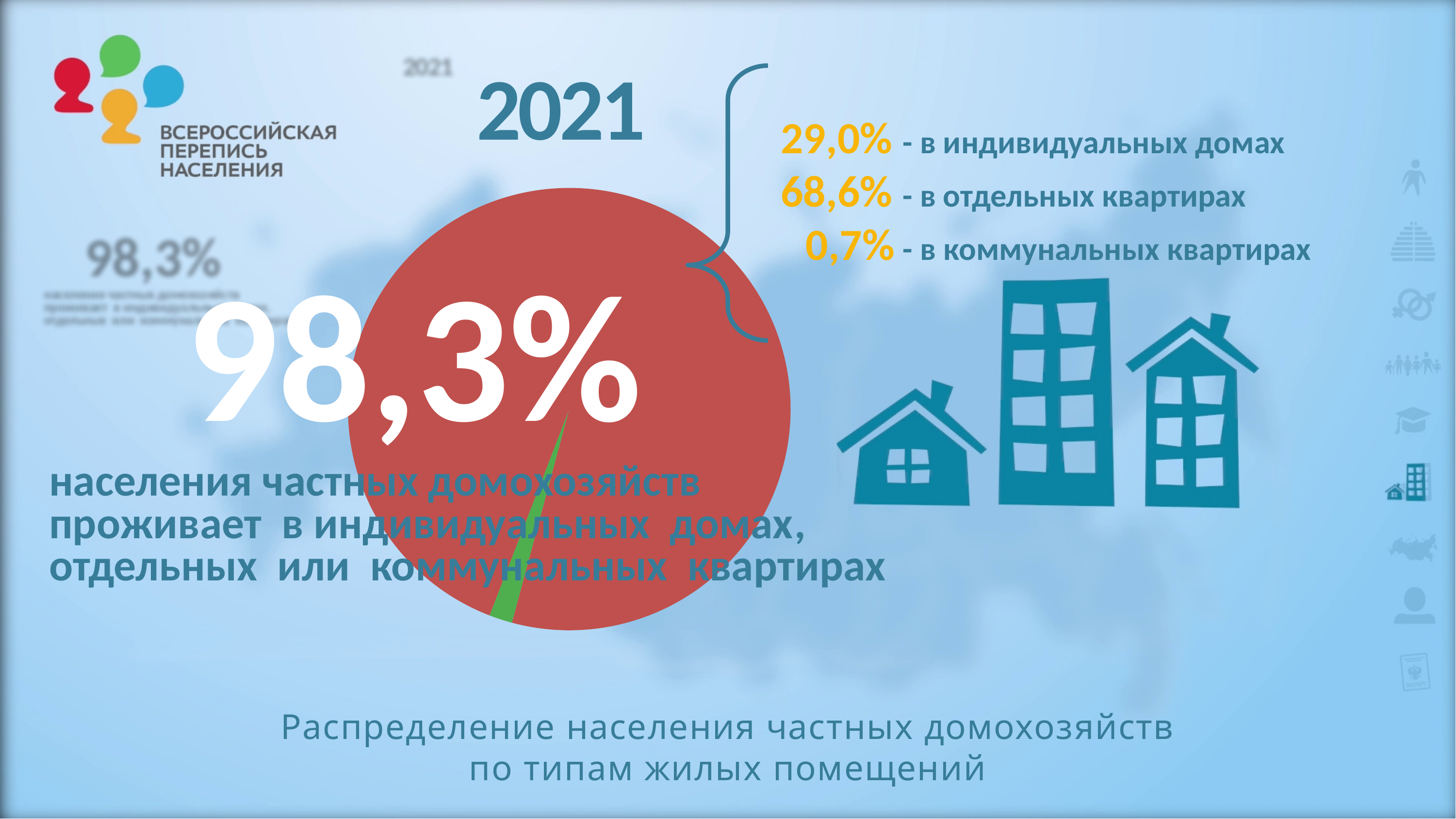
What is the difference between the share living in separate apartments and the share living in individual houses? 39,6% Which housing type has the smallest share of the private household population? в коммунальных квартирах What is the total of the three housing-type shares listed next to the pie chart? 98,3% Which housing type has the largest share of the private household population? в отдельных квартирах What percentage of the private household population lives in separate apartments (в отдельных квартирах)? 68,6% What is the title of the chart at the bottom of the slide? Распределение населения частных домохозяйств по типам жилых помещений What share of the private household population lives in individual houses, separate or communal apartments, according to the large label on the pie chart? 98,3% Which year does the chart refer to? 2021 Which is larger: the share living in individual houses or the share living in communal apartments? в индивидуальных домах What percentage of the private household population lives in communal apartments (в коммунальных квартирах)? 0,7% What kind of chart is shown on the slide? pie chart What percentage of the private household population lives in individual houses (в индивидуальных домах)? 29,0%